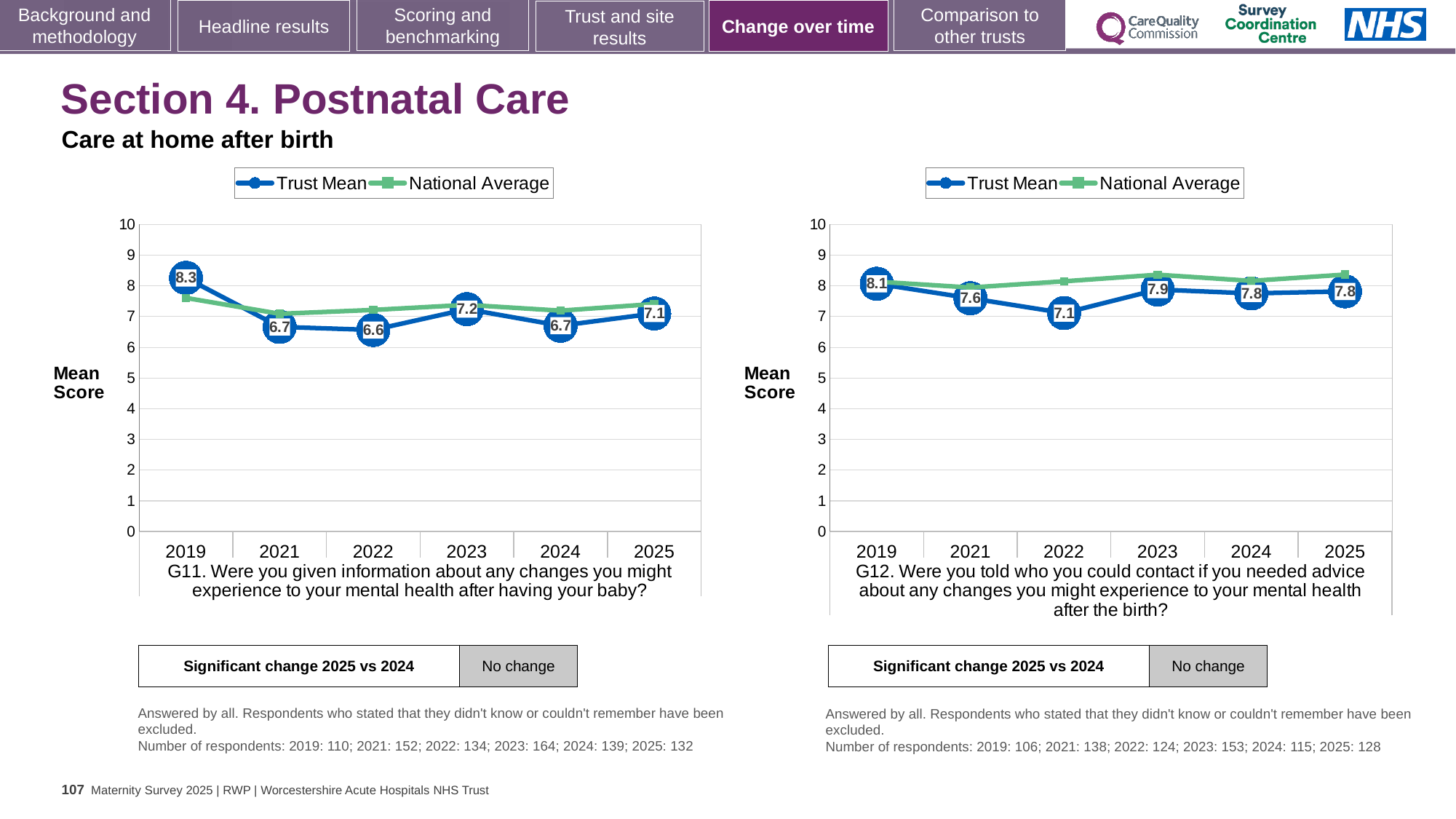
In the G12 chart, is the National Average for 2023 greater or less than 8? greater In the G11 chart, what is the difference between the Trust Mean scores for 2019 and 2025? 1.2 In the G12 chart, which is larger, the Trust Mean score for 2019 or for 2023? 2019 How many years are plotted on the x axis of the G11 chart? 6 In the G11 chart, which year has the lowest Trust Mean score? 2022 In the G12 chart, what is the Trust Mean score for 2021? 7.6 In the G12 chart, which year has the lowest Trust Mean score? 2022 How many series does the legend of the G12 chart list? 2 In the G11 chart, what is the Trust Mean score for 2022? 6.6 In the G11 chart, which year has the highest Trust Mean score? 2019 What type of chart is used for the G11 question? Line chart In the G11 chart, what is the Trust Mean score for 2019? 8.3